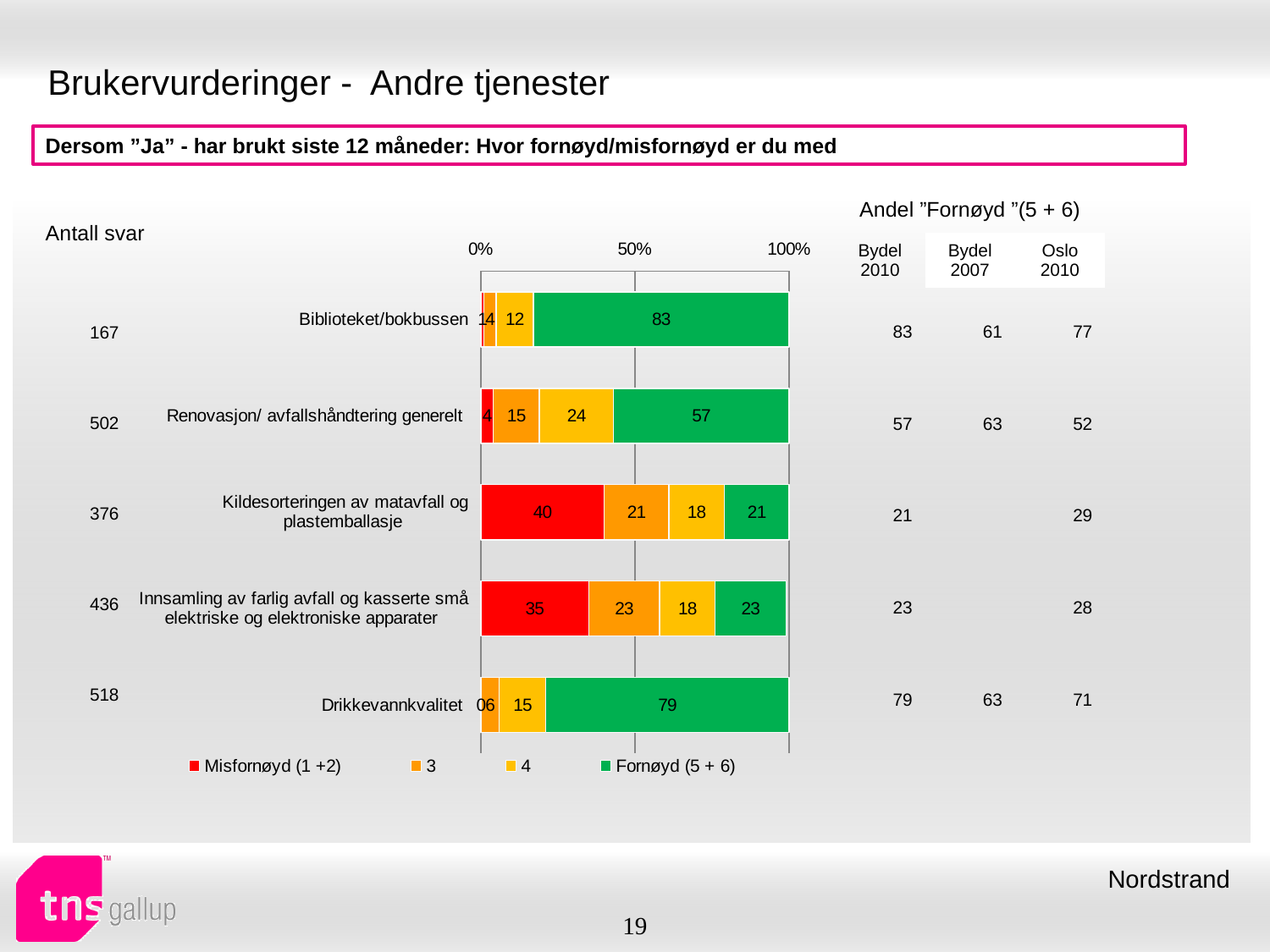
What is the 'Misfornøyd (1 +2)' value for Kildesorteringen av matavfall og plastemballasje? 40 What is the difference between the 'Fornøyd (5 + 6)' values for Drikkevannkvalitet and Renovasjon/ avfallshåndtering generelt? 22 What is the value of series '3' for Innsamling av farlig avfall og kasserte små elektriske og elektroniske apparater? 23 What kind of chart is shown on the slide? stacked bar chart Which category has the highest 'Fornøyd (5 + 6)' value? Biblioteket/bokbussen Which category has the lowest 'Fornøyd (5 + 6)' value? Kildesorteringen av matavfall og plastemballasje How many series does the chart legend list? 4 Which is larger: the 'Misfornøyd (1 +2)' value for Kildesorteringen av matavfall og plastemballasje or for Innsamling av farlig avfall og kasserte små elektriske og elektroniske apparater? Kildesorteringen av matavfall og plastemballasje What colour represents the 'Fornøyd (5 + 6)' series in the chart? green What is the value of series '4' for Renovasjon/ avfallshåndtering generelt? 24 What is the 'Fornøyd (5 + 6)' value for Biblioteket/bokbussen? 83 How many categories (services) are plotted in the chart? 5